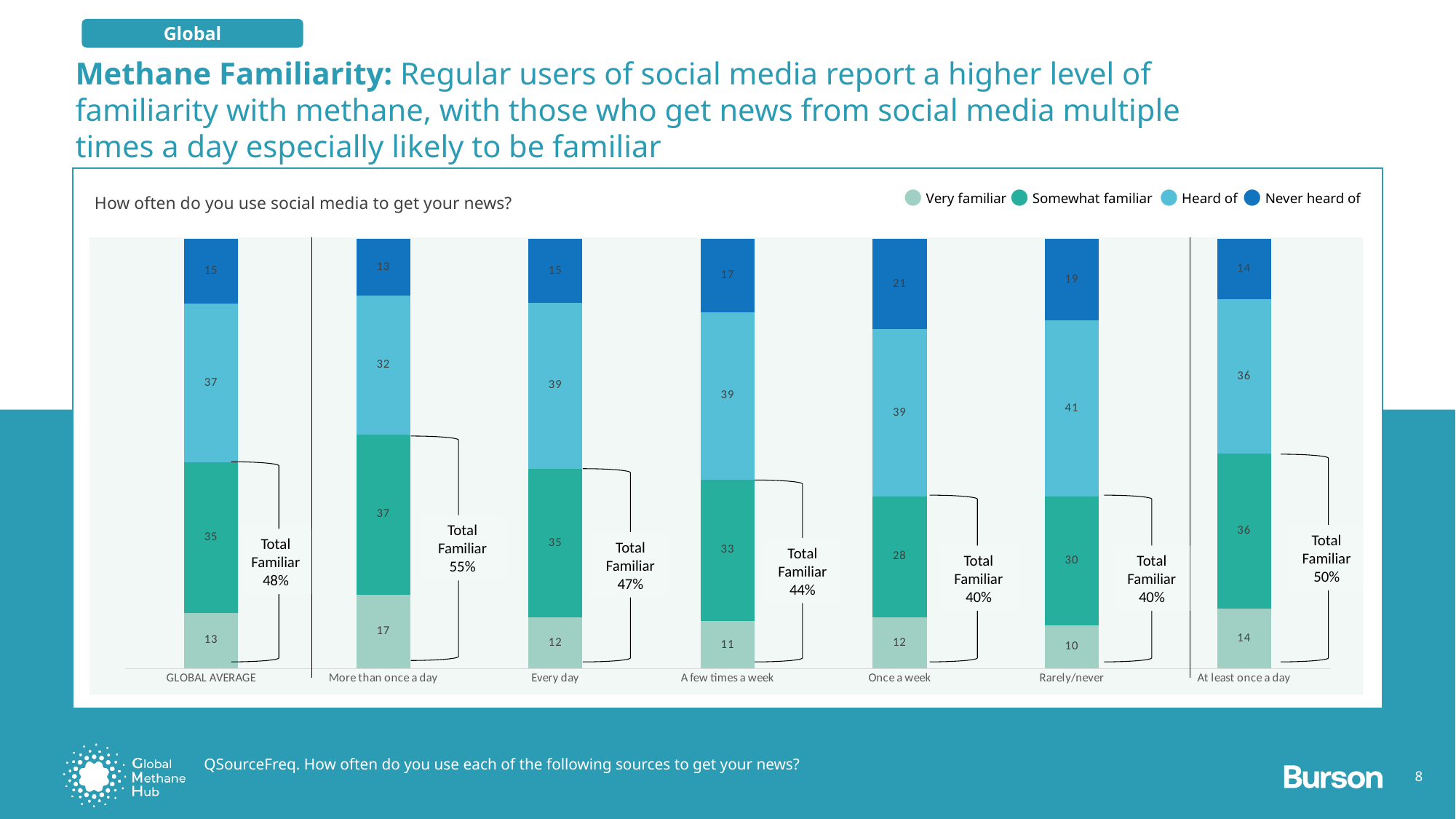
Which category has the highest 'Never heard of' value? Once a week How many series does the legend list? 4 What is the difference between the 'Somewhat familiar' values for 'More than once a day' and 'Once a week'? 9 Which category has the lowest 'Very familiar' value? Rarely/never What is the 'Heard of' value for 'Rarely/never'? 41 What kind of chart is shown on the slide? Stacked bar chart What is the total of the stacked bar for 'GLOBAL AVERAGE'? 100 What is the Total Familiar percentage shown for 'At least once a day'? 50% Which is larger: the 'Heard of' value for 'Every day' or for 'More than once a day'? Every day How many categories are shown along the x axis? 7 What is the 'Never heard of' value for 'Once a week'? 21 What is the 'Very familiar' value for 'More than once a day'? 17